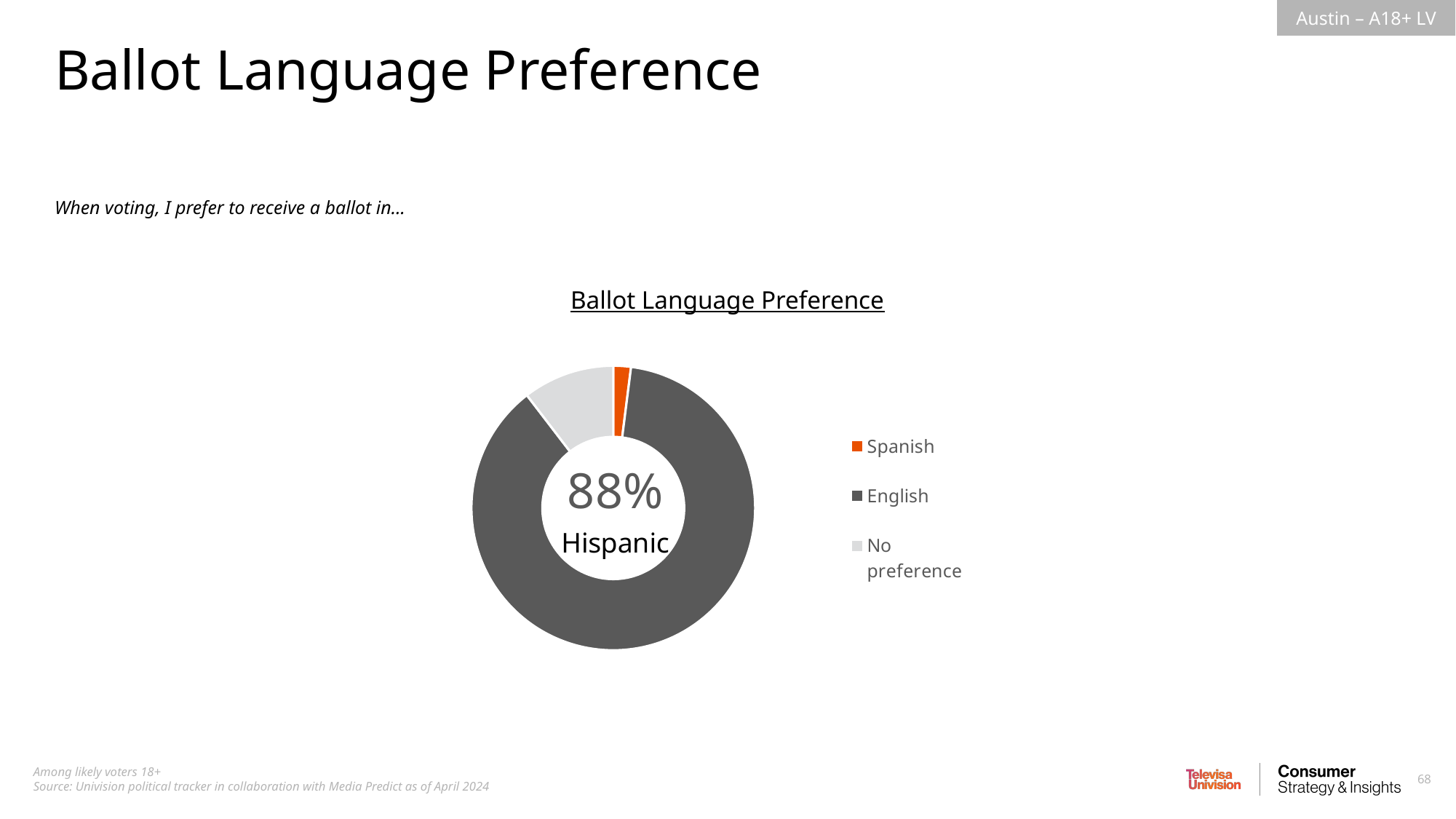
What are the legend entries of the chart, in order? Spanish, English, No preference What percentage is printed in the center of the donut chart? 88% Which has a larger share of the chart, No preference or Spanish? No preference Which category has the largest share of the Ballot Language Preference chart? English How many entries does the legend of the Ballot Language Preference chart list? 3 What is the title of the chart? Ballot Language Preference Which has a larger share of the chart, English or No preference? English Which category has the smallest share of the Ballot Language Preference chart? Spanish What kind of chart is shown on the slide? donut chart How many categories does the Ballot Language Preference chart show? 3